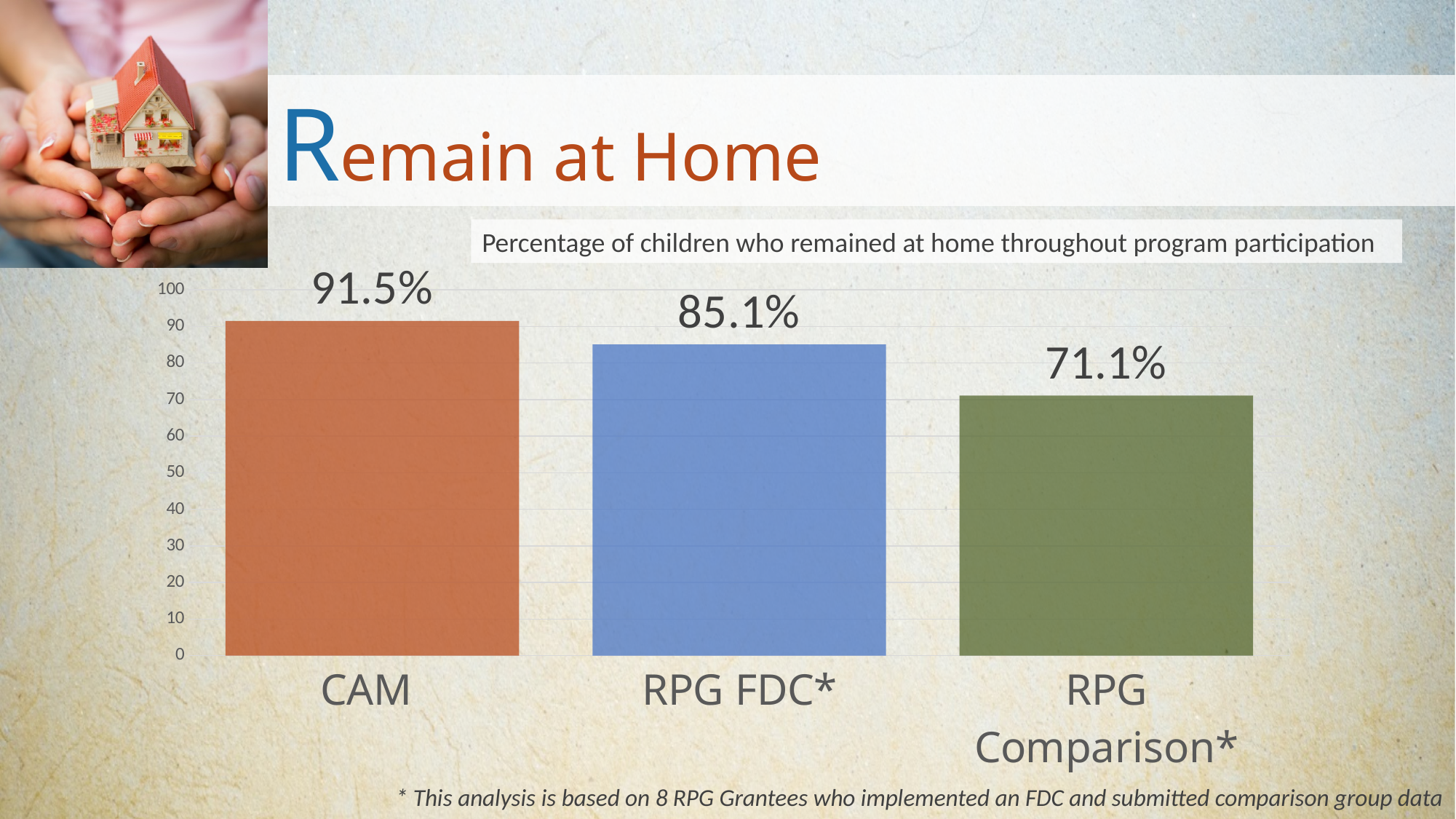
What kind of chart is shown on the slide? bar chart Is the value for RPG Comparison* greater or less than 80? less Which is larger, the value for CAM or the value for RPG FDC*? CAM Do the values rise or fall from left to right across the categories? fall What percentage of children remained at home for RPG Comparison*? 71.1% What is the difference in percentage points between CAM and RPG Comparison*? 20.4 What is the difference in percentage points between RPG FDC* and RPG Comparison*? 14 How many categories are shown in the chart? 3 Which category has the lowest percentage of children who remained at home? RPG Comparison* What percentage of children remained at home for RPG FDC*? 85.1% Which category has the highest percentage of children who remained at home? CAM What percentage of children remained at home for CAM? 91.5%